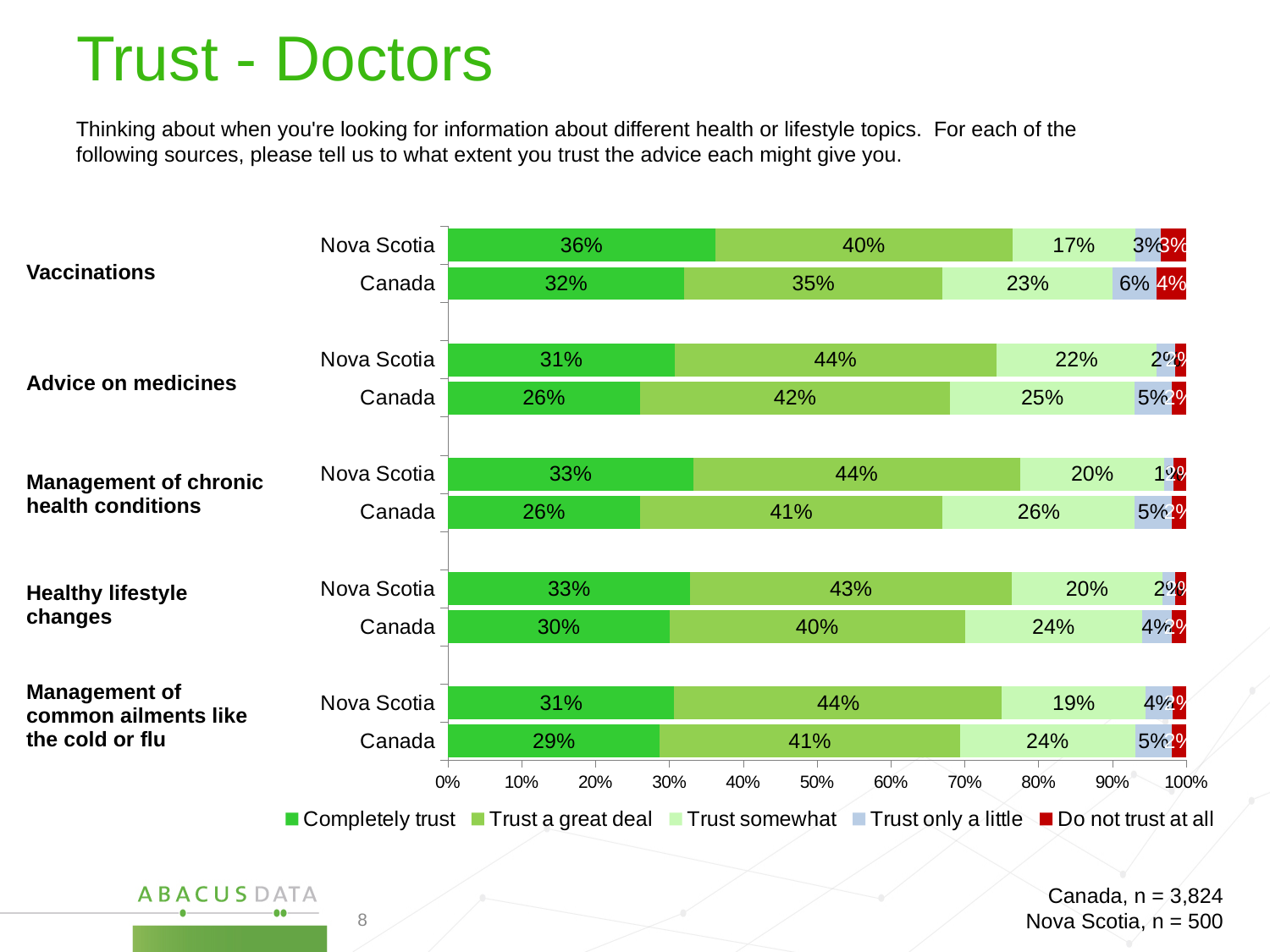
For management of chronic health conditions, what percentage of Canada respondents said they "Trust somewhat"? 26% Which bar has the highest "Completely trust" value? Nova Scotia, Vaccinations (36%) For vaccinations, what share of Canada respondents said they "Trust a great deal"? 35% What is the "Trust a great deal" value for Nova Scotia on advice on medicines? 44% For advice on medicines, which has the larger "Trust a great deal" value, Nova Scotia or Canada? Nova Scotia What kind of chart is shown on the slide? Stacked bar chart For management of common ailments like the cold or flu, what is the "Trust somewhat" value for Nova Scotia? 19% How many series does the legend list? 5 For vaccinations, how many percentage points higher is the "Completely trust" value for Nova Scotia than for Canada? 4 percentage points What is the "Completely trust" value for Canada on healthy lifestyle changes? 30% Which bar has the lowest "Trust somewhat" value? Nova Scotia, Vaccinations (17%) What percentage of Nova Scotia respondents said they "Completely trust" doctors for advice on vaccinations? 36%